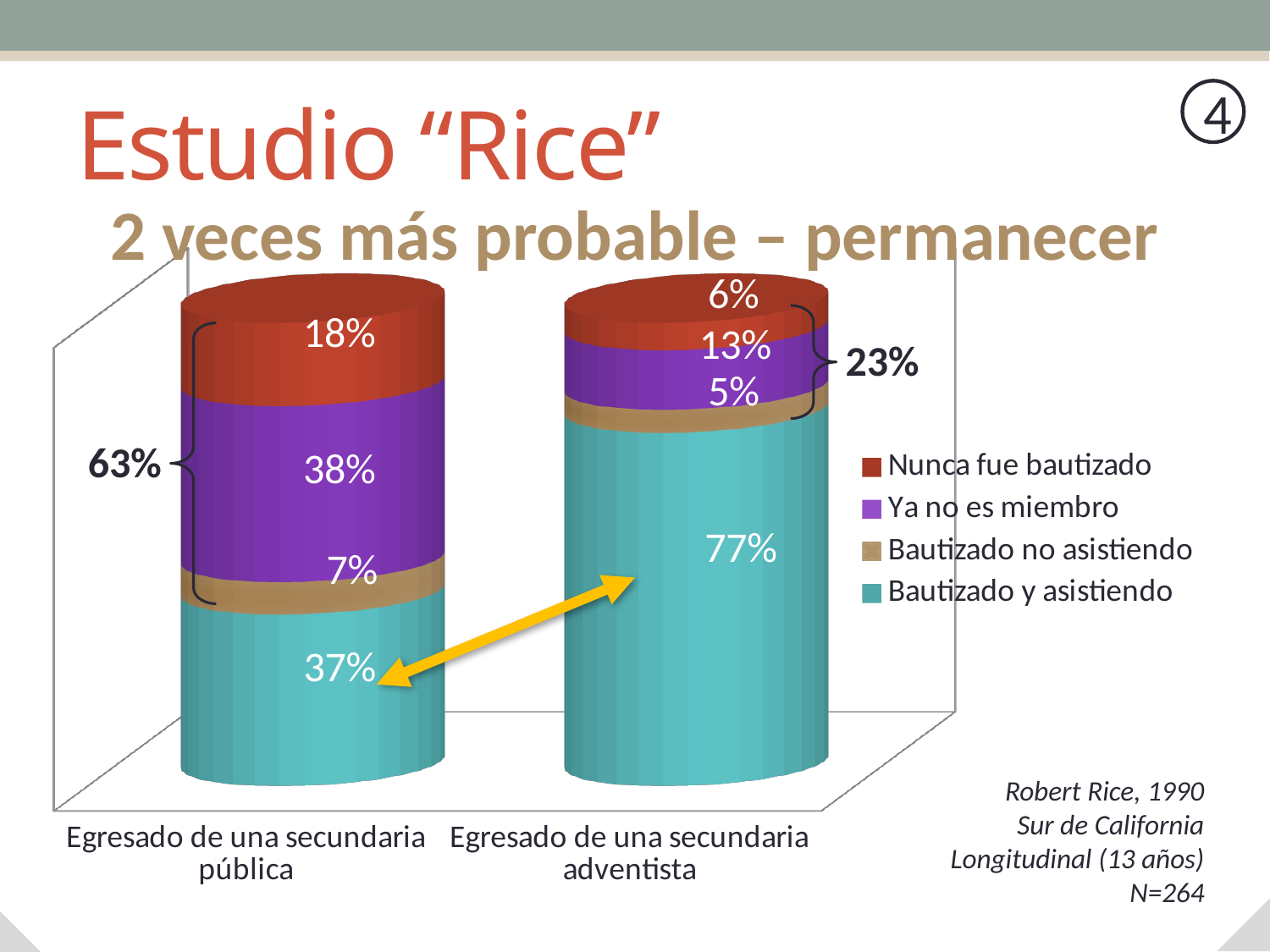
How many categories are shown on the x axis? 2 How many series does the legend list? 4 What is the value for "Bautizado no asistiendo" for "Egresado de una secundaria pública"? 7% Which category has the larger "Ya no es miembro" value? Egresado de una secundaria pública Which series is shown in red in the legend? Nunca fue bautizado What is the difference between the "Bautizado y asistiendo" values for the adventista and pública graduates? 40% What is the value for "Bautizado y asistiendo" for "Egresado de una secundaria adventista"? 77% What is the value for "Nunca fue bautizado" for "Egresado de una secundaria adventista"? 6% What kind of chart is shown on the slide? stacked bar chart What is the value for "Bautizado y asistiendo" for "Egresado de una secundaria pública"? 37% Which series has the largest value for "Egresado de una secundaria adventista"? Bautizado y asistiendo What is the value for "Ya no es miembro" for "Egresado de una secundaria pública"? 38%